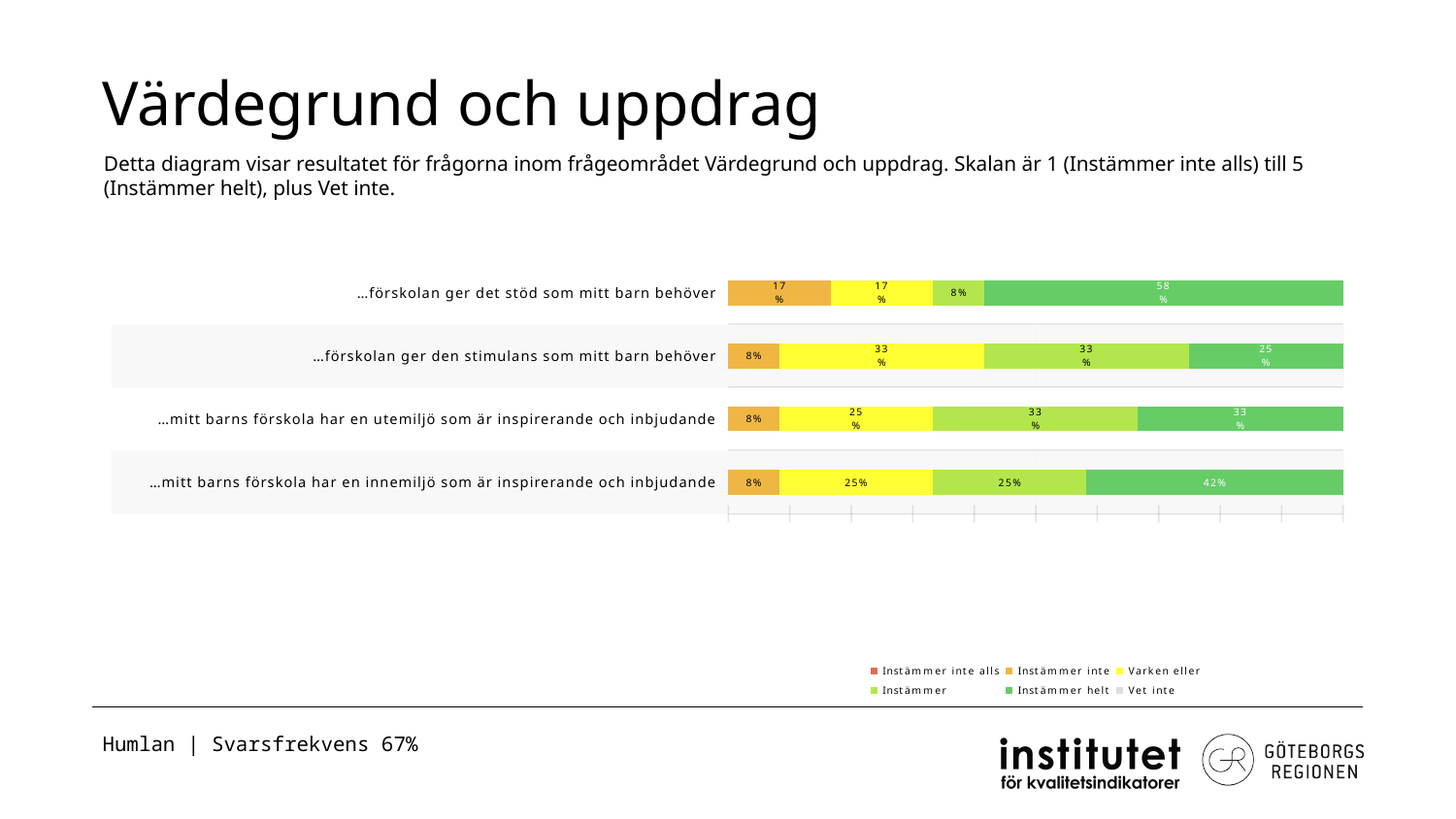
What is the 'Instämmer inte' value for '…mitt barns förskola har en utemiljö som är inspirerande och inbjudande'? 8% What kind of chart is shown on the slide? Stacked bar chart Which question has the lowest 'Instämmer' value? …förskolan ger det stöd som mitt barn behöver How many series does the legend list? 6 What is the 'Varken eller' value for '…förskolan ger den stimulans som mitt barn behöver'? 33% Which question has the highest 'Instämmer helt' value? …förskolan ger det stöd som mitt barn behöver What is the total of the labelled segments for '…mitt barns förskola har en innemiljö som är inspirerande och inbjudande'? 100% What is the 'Instämmer helt' value for '…mitt barns förskola har en innemiljö som är inspirerande och inbjudande'? 42% What is the difference between the 'Instämmer helt' values for '…förskolan ger det stöd som mitt barn behöver' and '…förskolan ger den stimulans som mitt barn behöver'? 33% Which is larger: the 'Instämmer inte' value for '…förskolan ger det stöd som mitt barn behöver' or for '…förskolan ger den stimulans som mitt barn behöver'? …förskolan ger det stöd som mitt barn behöver How many questions (bars) are shown in the chart? 4 What is the 'Instämmer helt' value for '…förskolan ger det stöd som mitt barn behöver'? 58%